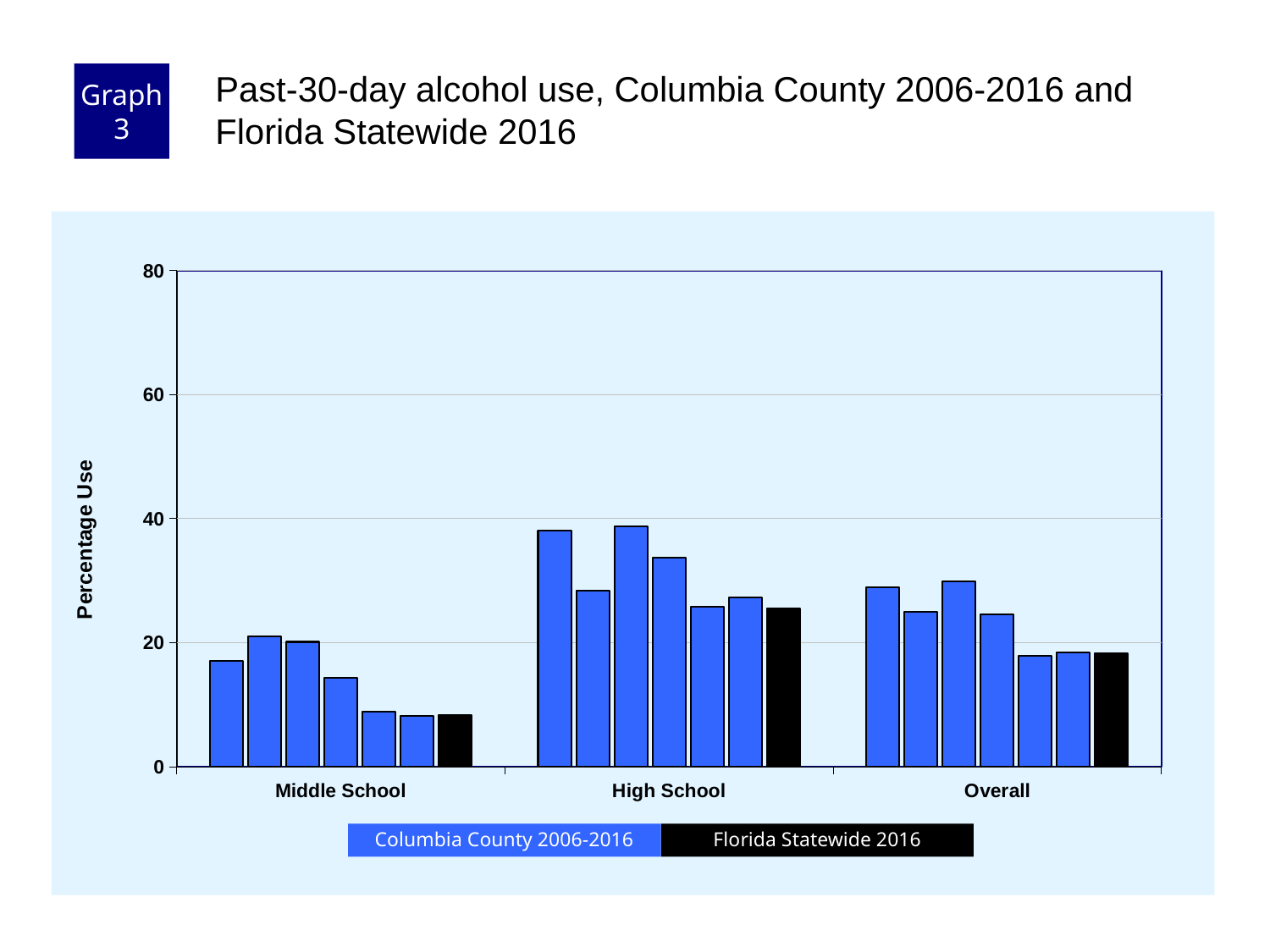
Is the Florida Statewide 2016 value for Overall greater or less than 20? less What kind of chart is shown on the slide? bar chart How many series does the legend list? 2 Which category contains the tallest bar in the chart? High School Is the Florida Statewide 2016 value for High School greater or less than 20? greater Which category has the lowest Florida Statewide 2016 value? Middle School What is the label on the vertical axis? Percentage Use Which is larger, the Florida Statewide 2016 value for High School or for Overall? High School What colour are the Florida Statewide 2016 bars? black Is the Florida Statewide 2016 value for Middle School greater or less than 20? less Which category has the highest Florida Statewide 2016 value? High School How many categories are shown along the x axis? 3